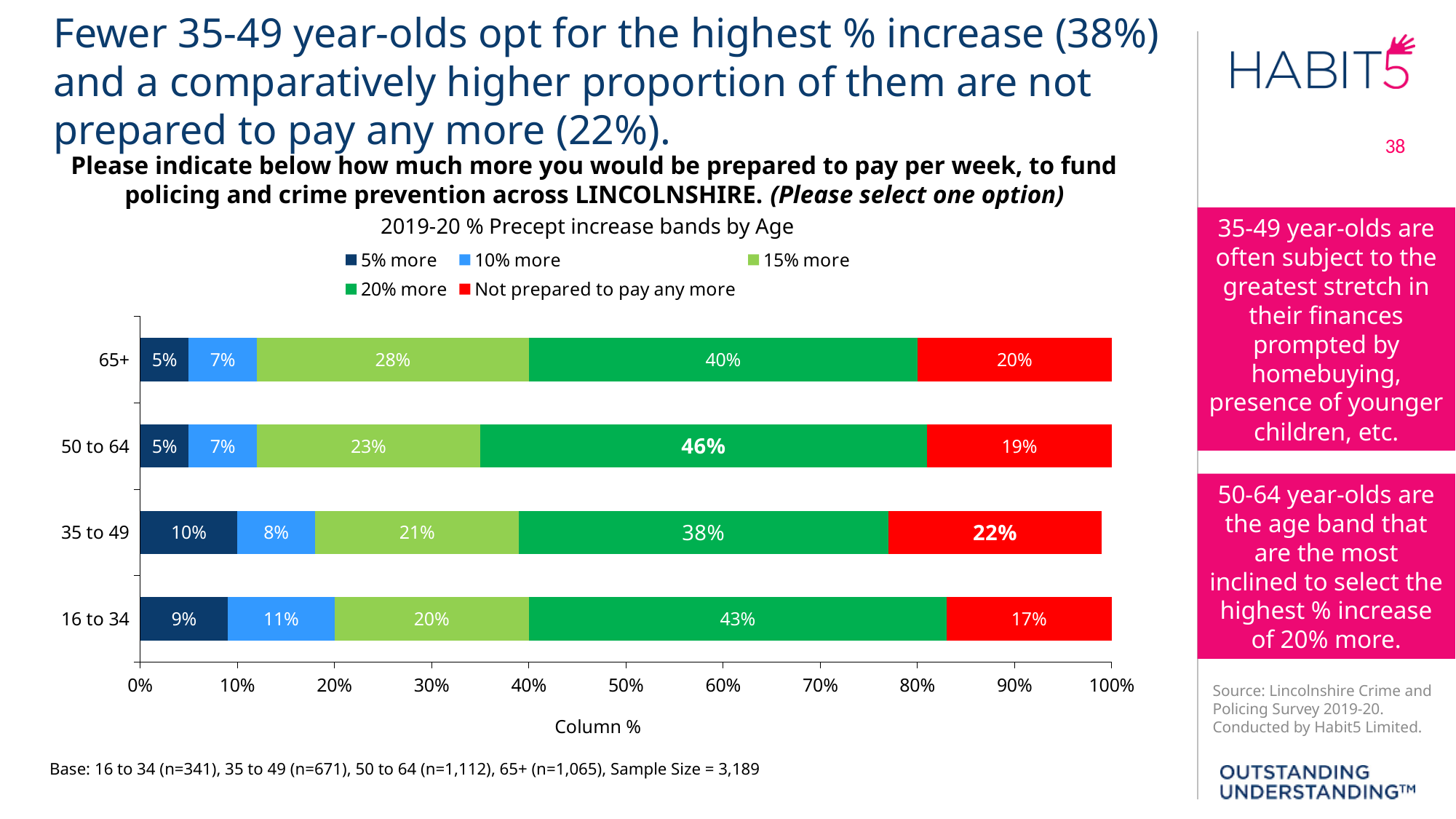
Which age band has the lowest percentage 'Not prepared to pay any more'? 16 to 34 Which age band has the highest percentage choosing '20% more'? 50 to 64 What percentage of 16 to 34 year-olds chose '10% more'? 11% What is the title of the chart? 2019-20 % Precept increase bands by Age What type of chart is shown on the slide? Stacked bar chart What percentage of 35 to 49 year-olds are 'Not prepared to pay any more'? 22% How many age bands are shown in the chart? 4 What percentage of 65+ year-olds chose '15% more'? 28% What is the difference between the '20% more' percentages for 16 to 34 and 35 to 49 year-olds? 5% What percentage of 50 to 64 year-olds chose '20% more'? 46% Which is larger: the '5% more' share for 35 to 49 or for 65+? 35 to 49 How many series does the legend list? 5